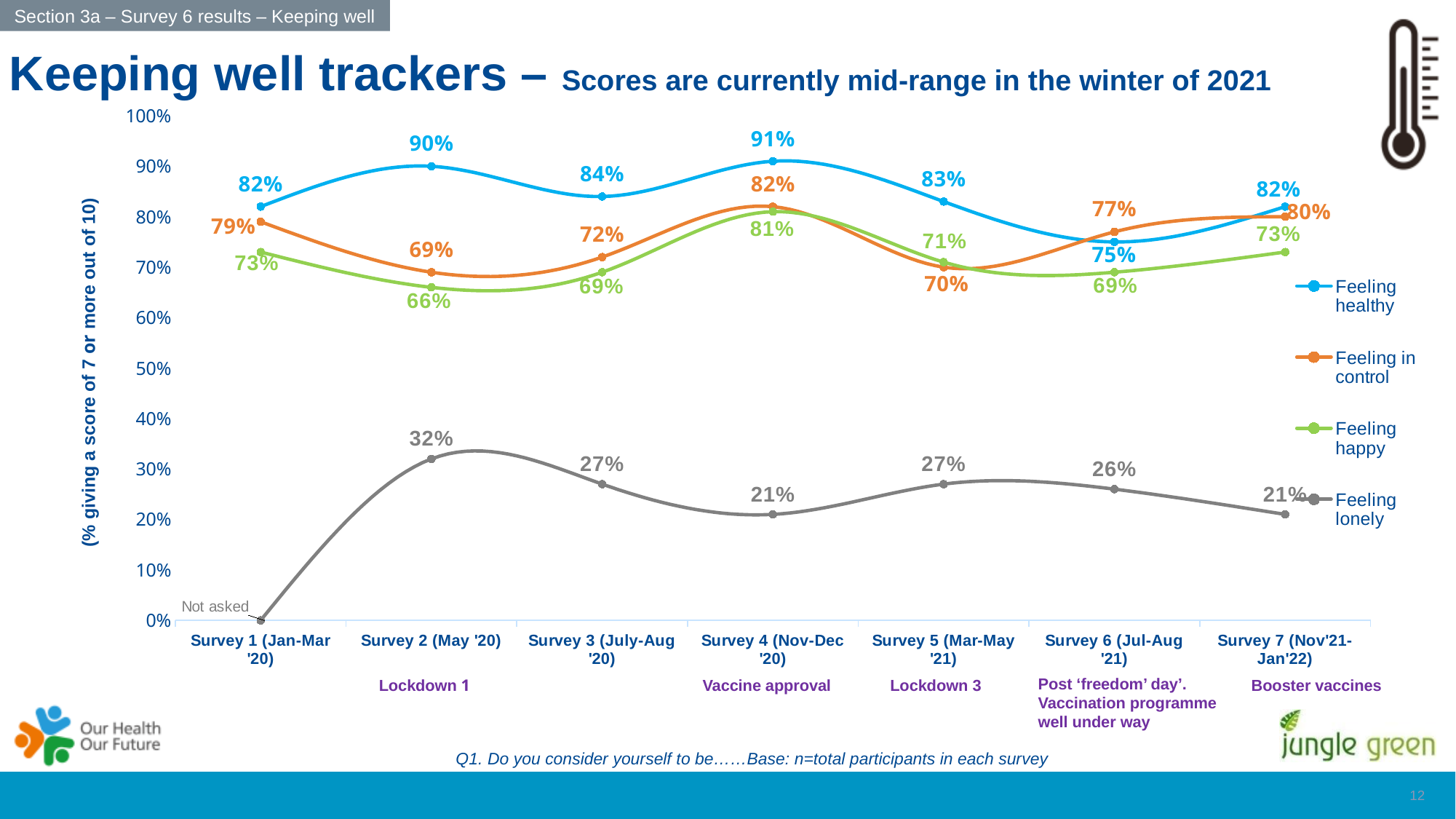
How many series does the legend list? 4 What is the difference between the Feeling healthy values for Survey 2 (May '20) and Survey 6 (Jul-Aug '21)? 15 percentage points What does the chart show for Feeling lonely in Survey 1 (Jan-Mar '20)? Not asked What is the Feeling healthy value for Survey 4 (Nov-Dec '20)? 91% In which survey is the Feeling healthy score highest? Survey 4 (Nov-Dec '20) What is the Feeling lonely value for Survey 2 (May '20)? 32% Does the Feeling lonely score rise or fall from Survey 5 (Mar-May '21) to Survey 7 (Nov'21-Jan'22)? Fall How many surveys are shown along the x axis? 7 In Survey 6 (Jul-Aug '21), which is higher: Feeling in control or Feeling healthy? Feeling in control What is the Feeling in control value for Survey 7 (Nov'21-Jan'22)? 80% In which survey is the Feeling happy score lowest? Survey 2 (May '20) What kind of chart is shown on the slide? Line chart